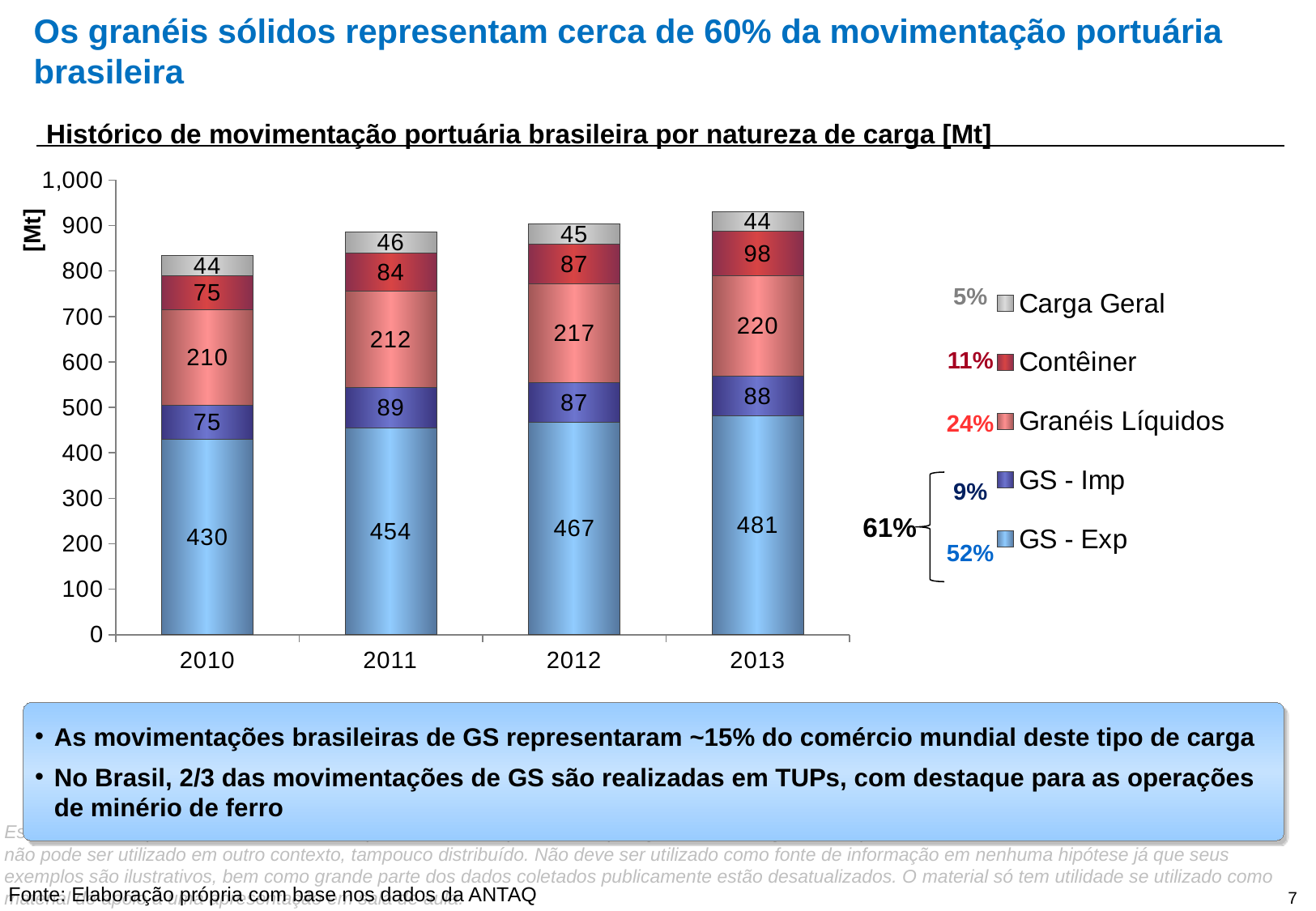
What is the value for Contêiner in 2010? 75 Which year has the highest value for GS - Exp? 2013 What is the value for Granéis Líquidos in 2011? 212 What is the value for GS - Exp in 2013? 481 What kind of chart is shown on the slide? Stacked bar chart How many years are shown on the x axis? 4 What is the total of the stacked bar for 2010? 834 What is the difference between the GS - Exp values for 2013 and 2010? 51 How many series does the legend list? 5 Is the Contêiner value larger in 2013 or in 2012? 2013 Which year has the lowest value for Contêiner? 2010 What is the total of the stacked bar for 2013? 931